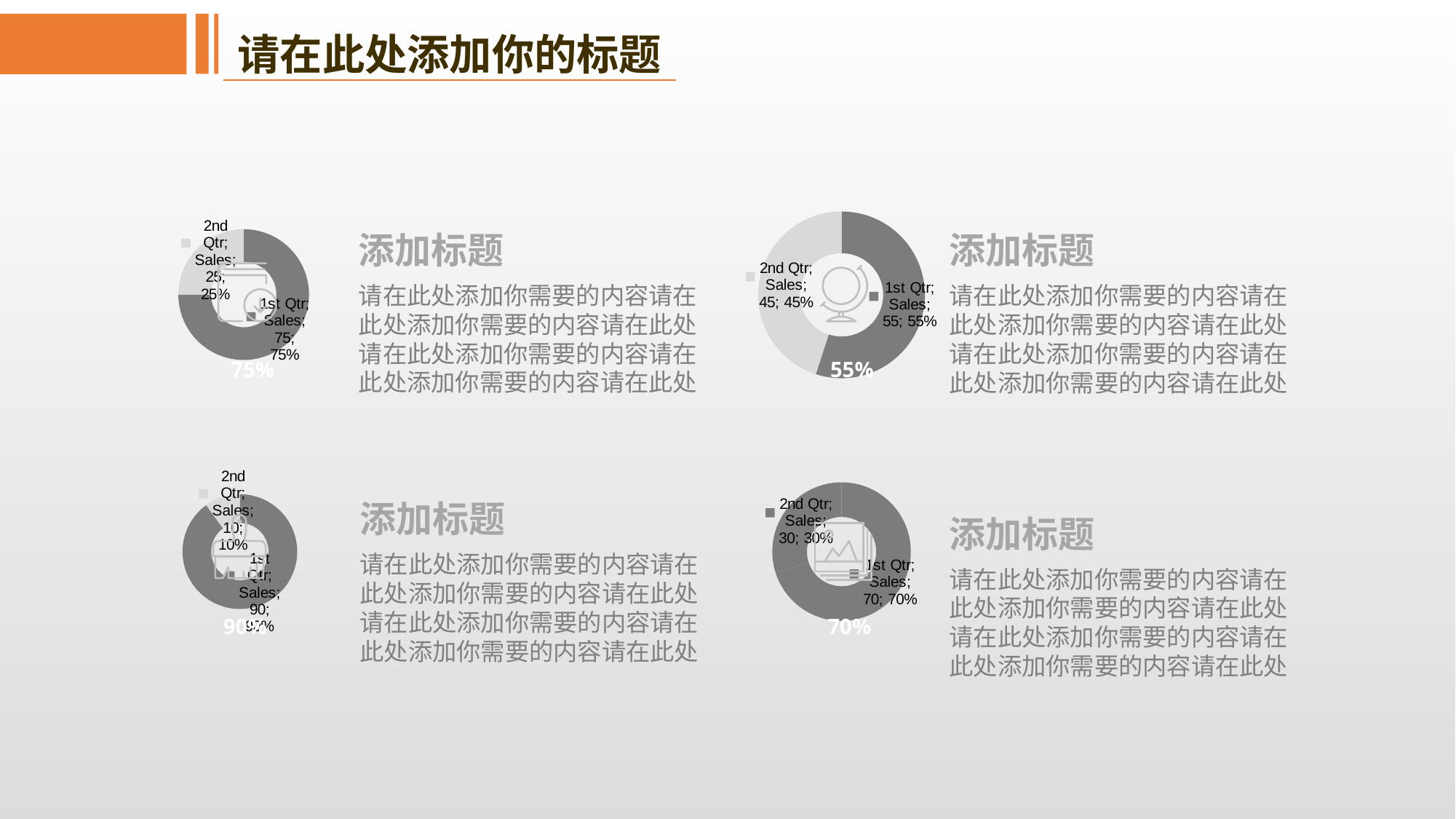
In the top-right doughnut chart, what is the difference between the 1st Qtr and 2nd Qtr values? 10 How many categories does the bottom-right doughnut chart show? 2 In the top-right doughnut chart, what is the value for 2nd Qtr? 45 In the bottom-right doughnut chart, what is the difference between the 1st Qtr and 2nd Qtr values? 40 In the top-left doughnut chart, what share of the whole does 2nd Qtr represent? 25% In the bottom-left doughnut chart, what is the value for 2nd Qtr? 10 In the bottom-left doughnut chart, which category has the smallest value? 2nd Qtr In the bottom-right doughnut chart, what is the value for 1st Qtr? 70 In the top-left doughnut chart, what is the value for 1st Qtr? 75 What type of chart is shown in the top-left of the slide? Doughnut chart In the bottom-left doughnut chart, what share of the whole does 1st Qtr represent? 90% In the top-right doughnut chart, which quarter has the larger value, 1st Qtr or 2nd Qtr? 1st Qtr